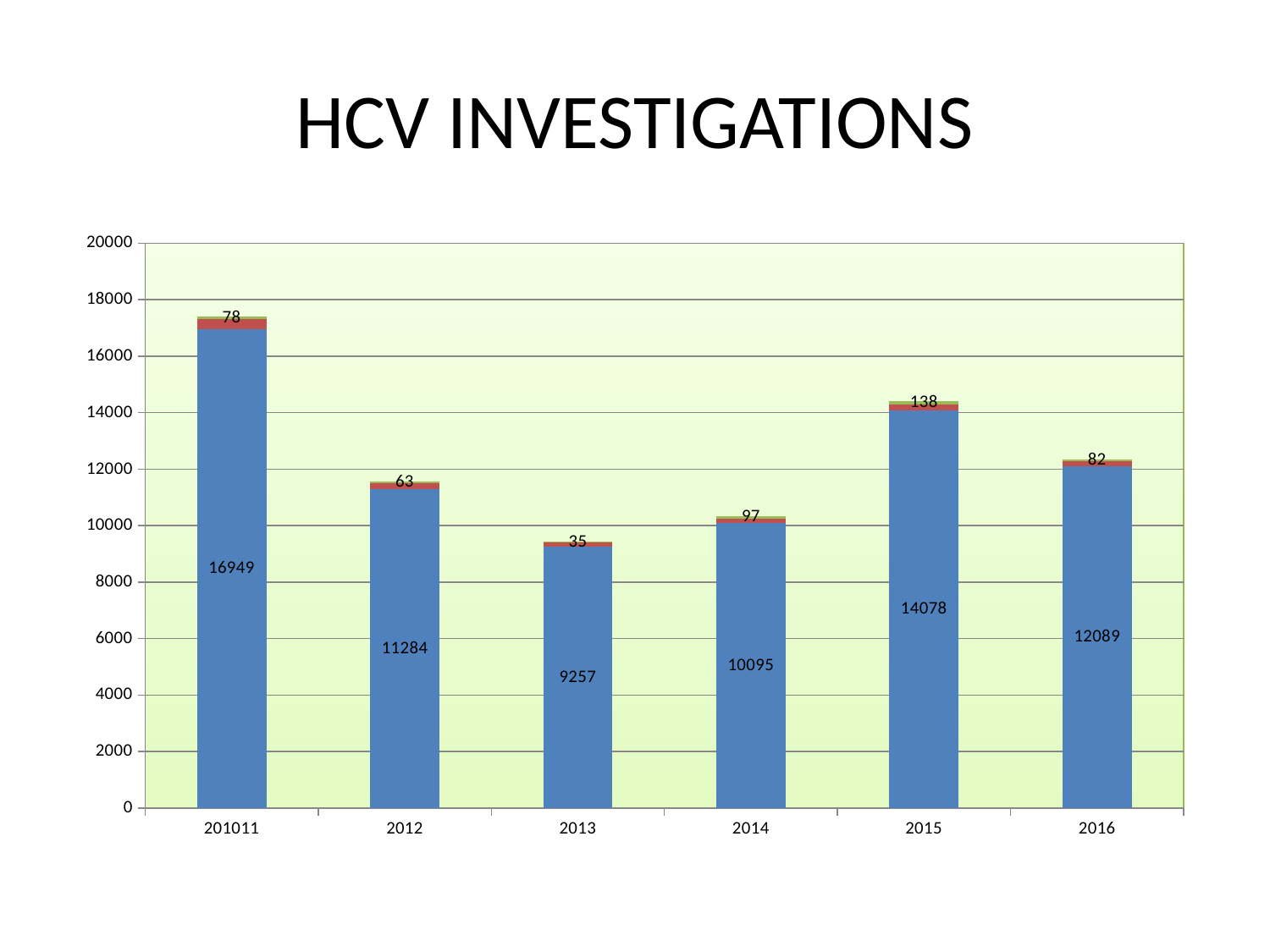
Which has the larger blue segment value, 2012 or 2014? 2012 How many years are shown on the x axis? 6 What kind of chart is shown on the slide? bar chart What is the value labelled on the blue segment for 2013? 9257 Is the total height of the bar for 2016 greater or less than 12000? greater What is the small value labelled at the top of the bar for 2015? 138 What is the title of the chart? HCV INVESTIGATIONS Which year has the shortest bar? 2013 Which year has the tallest bar? 201011 What is the value labelled on the blue segment for 201011? 16949 What is the difference between the blue segment values for 201011 and 2012? 5665 What is the difference between the blue segment values for 2015 and 2016? 1989